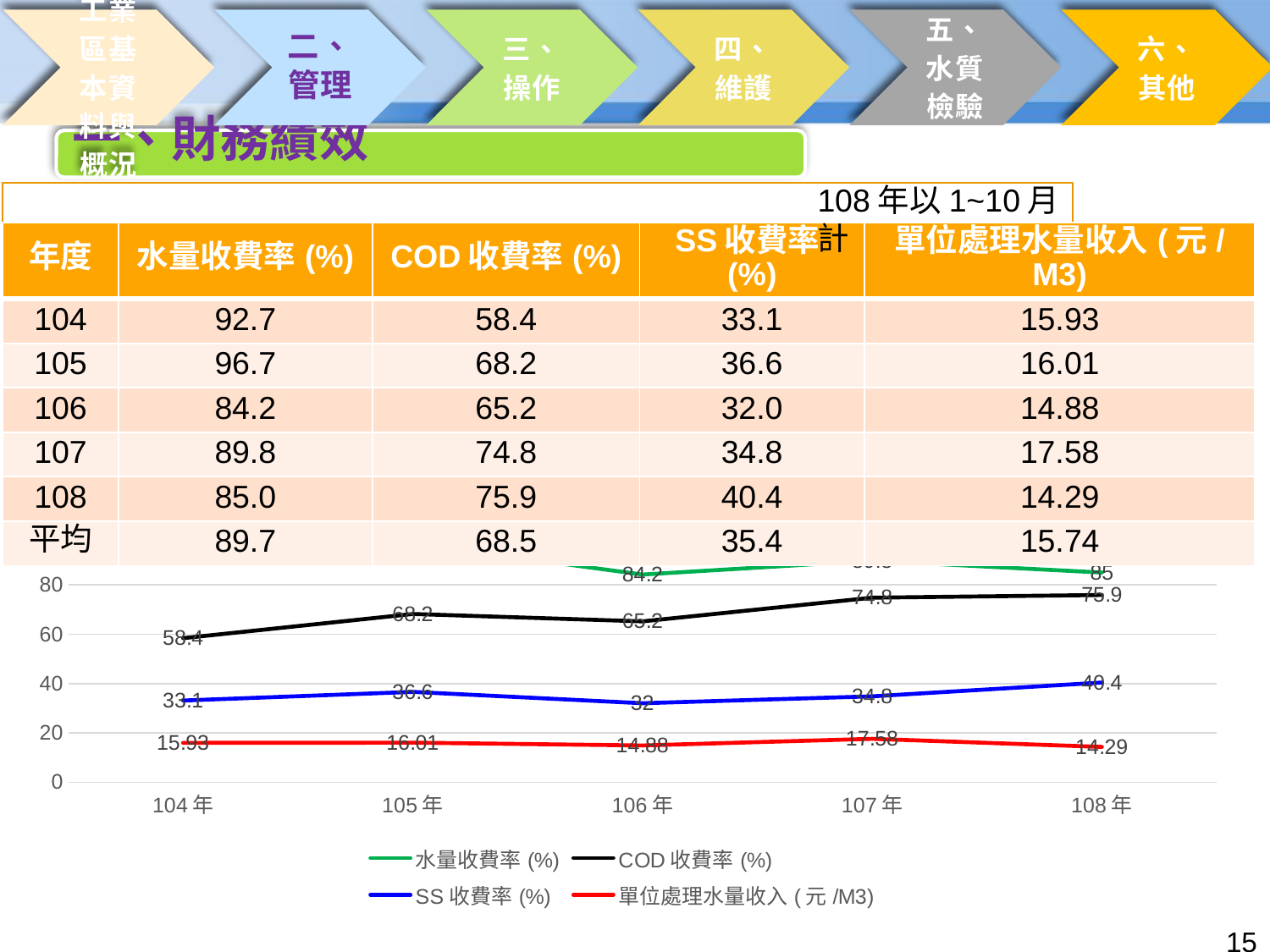
What type of chart is shown at the bottom of the slide? line chart What is the difference between the COD 收費率 (%) values for 108 年 and 104 年 in the chart? 17.5 In which year is 單位處理水量收入 (元/M3) highest in the chart? 107 年 How many years are plotted along the x axis of the chart? 5 What is the value of 單位處理水量收入 (元/M3) for 106 年 in the chart? 14.88 Is the COD 收費率 (%) value for 105 年 greater or less than 60? greater What is the value of SS 收費率 (%) for 108 年 in the chart? 40.4 What is the value of COD 收費率 (%) for 107 年 in the chart? 74.8 What colour is the line for SS 收費率 (%) in the chart? blue How many series does the chart legend list? 4 Which is larger in the chart: SS 收費率 (%) for 105 年 or for 106 年? 105 年 In which year is COD 收費率 (%) lowest in the chart? 104 年